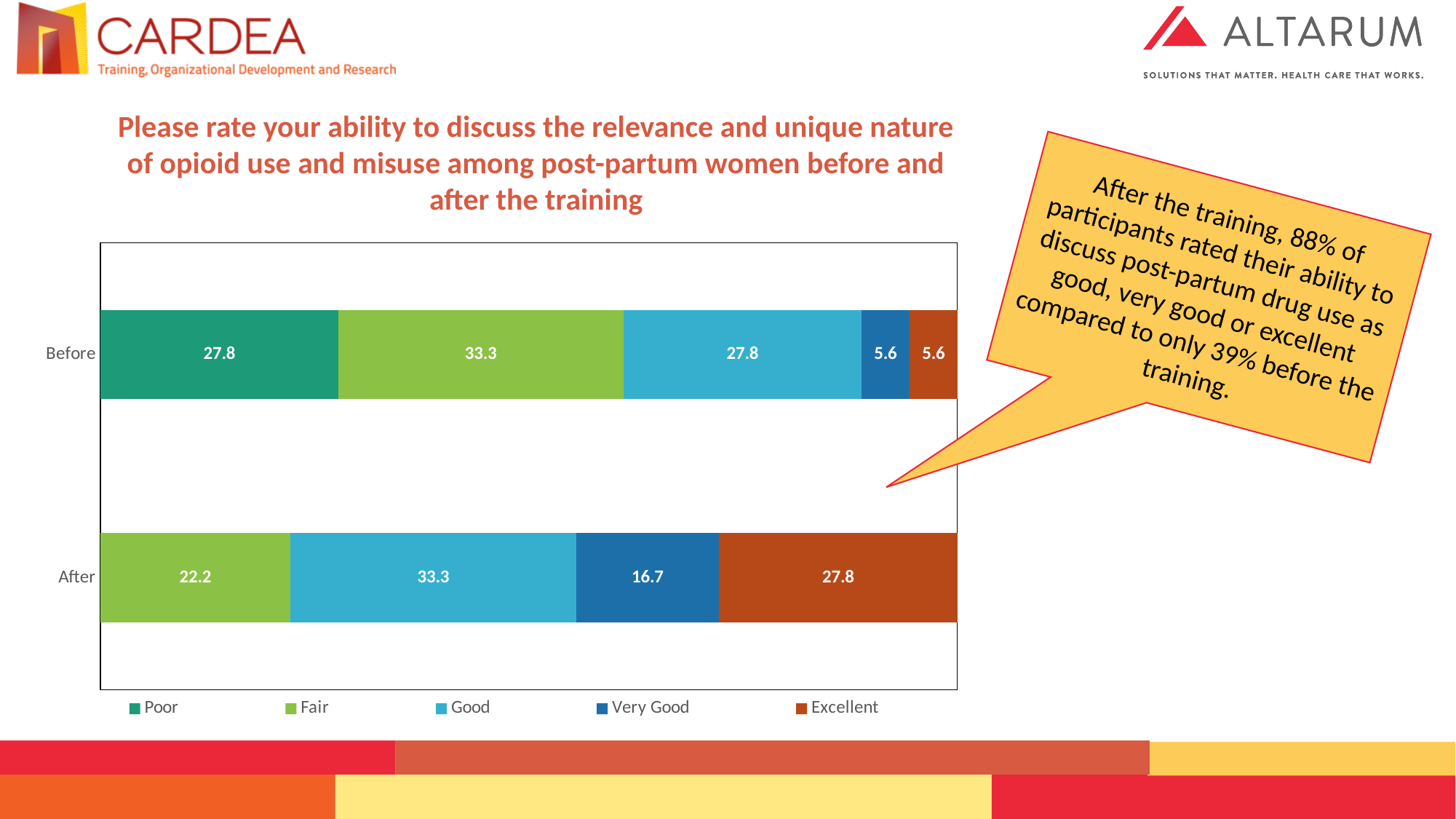
Which legend entry is shown in dark blue? Very Good Which rating has the largest segment in the Before bar? Fair What is the difference between the Excellent value in the After bar and the Excellent value in the Before bar? 22.2 What is the value for Very Good in the Before bar? 5.6 What kind of chart is shown on the slide? Stacked bar chart What is the value for Good in the After bar? 33.3 What is the value for Fair in the Before bar? 33.3 How many series does the legend list? 5 Which is larger: the Very Good value in the After bar or the Very Good value in the Before bar? After Which rating has the largest segment in the After bar? Good How many categories (bars) are plotted on the chart? 2 What is the value for Excellent in the After bar? 27.8